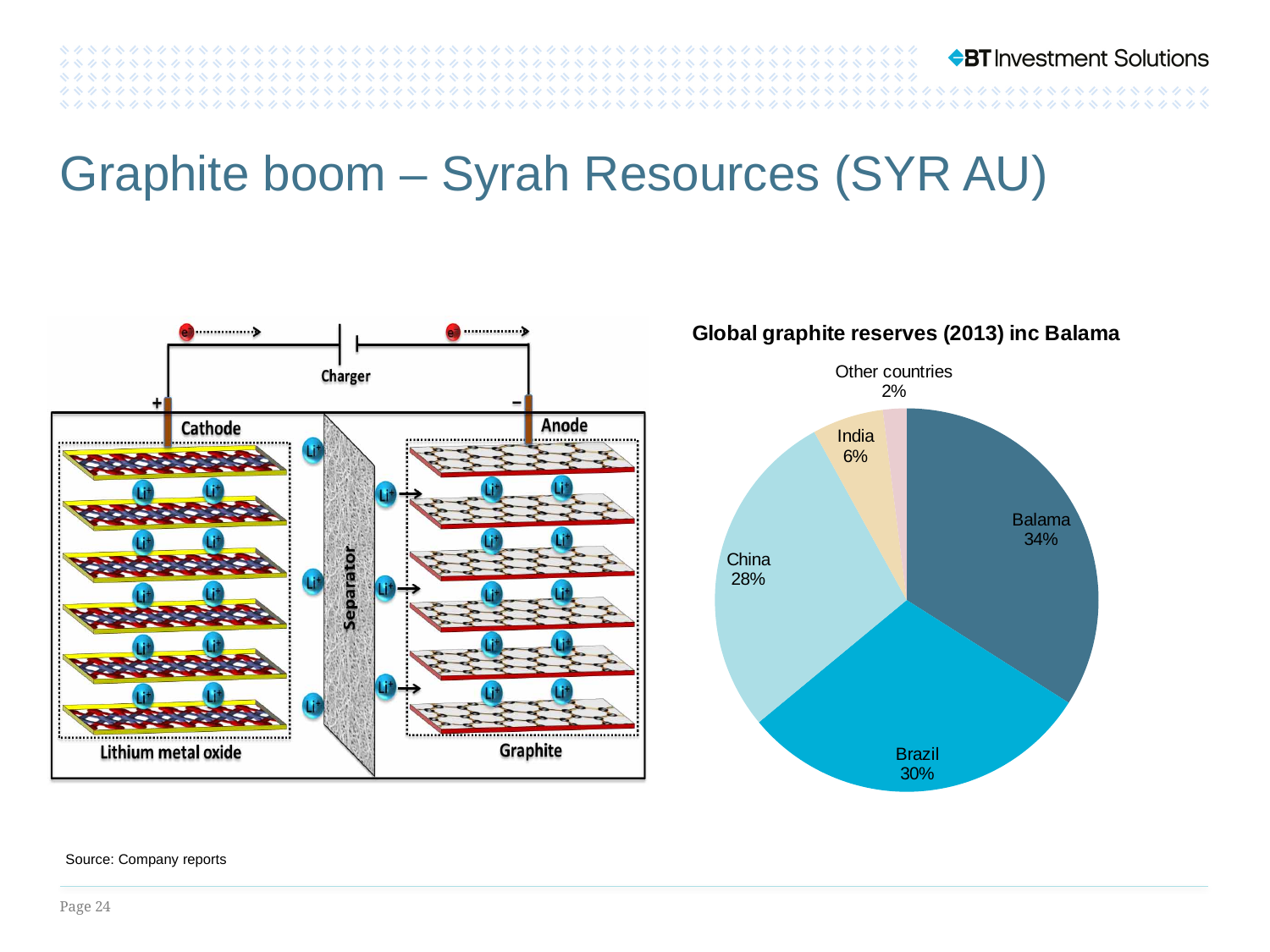
What share of global graphite reserves (2013) does Balama hold? 34% What share of global graphite reserves (2013) does China hold? 28% What share of global graphite reserves (2013) is attributed to Other countries? 2% Which category has the largest share of global graphite reserves (2013) in the pie chart? Balama What share of global graphite reserves (2013) does Brazil hold? 30% Which category has the smallest share of global graphite reserves (2013) in the pie chart? Other countries Which has a larger share of global graphite reserves (2013), Brazil or China? Brazil What is the title of the pie chart on the slide? Global graphite reserves (2013) inc Balama How many slices does the global graphite reserves (2013) pie chart have? 5 What is the difference in percentage points between Balama's and China's shares of global graphite reserves (2013)? 6 What share of global graphite reserves (2013) does India hold? 6% What type of chart is used to show global graphite reserves (2013) inc Balama? pie chart